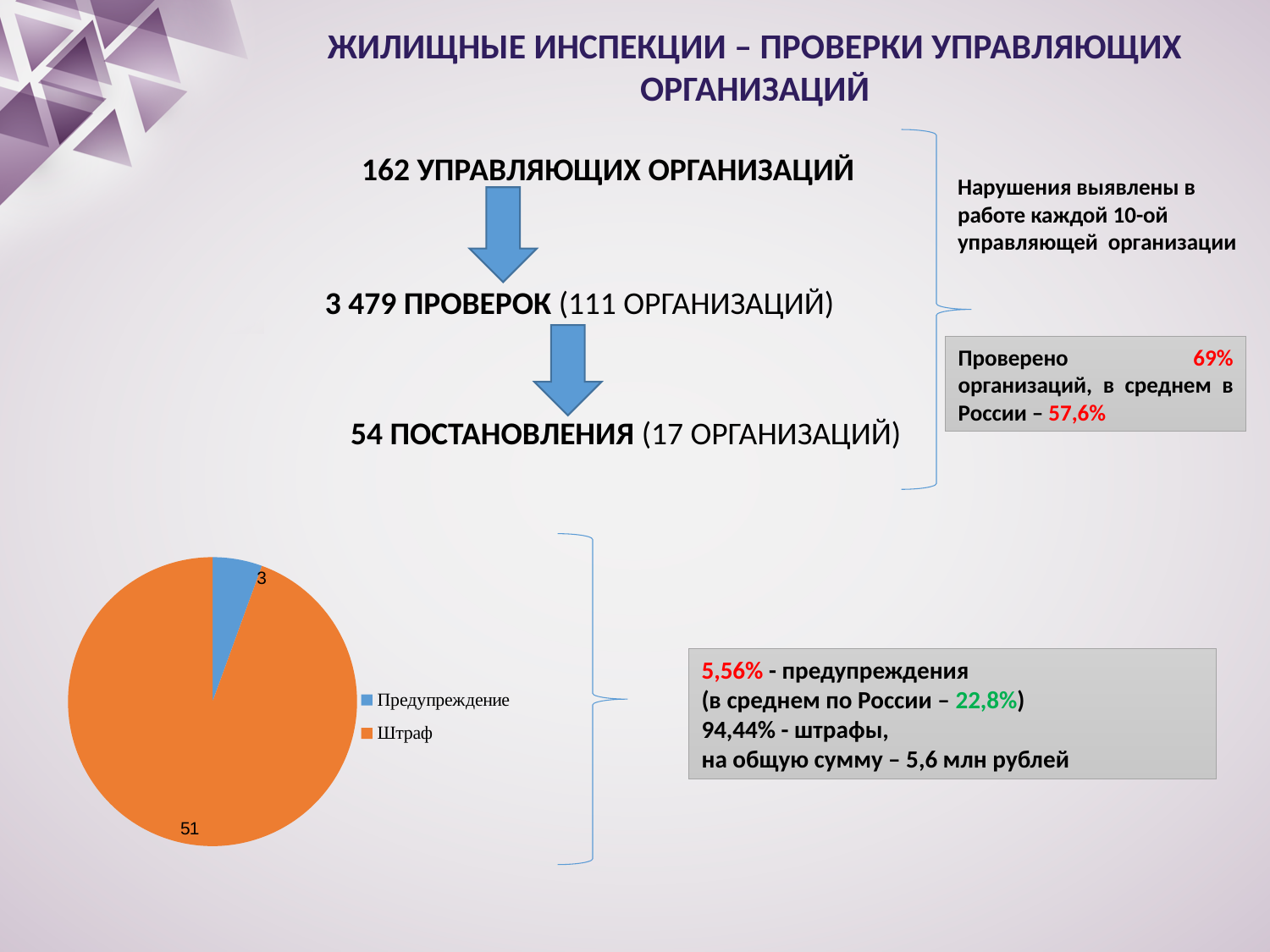
What share of the pie chart does Предупреждение represent? 5,56% How many slices does the pie chart have? 2 What colour is the Штраф slice in the pie chart? orange What is the difference between the values for Штраф and Предупреждение in the pie chart? 48 What is the value for Предупреждение in the pie chart? 3 Which category has the smallest slice in the pie chart? Предупреждение Which category has the largest slice in the pie chart? Штраф What is the value for Штраф in the pie chart? 51 What kind of chart is shown on the slide? pie chart Which is larger in the pie chart, Предупреждение or Штраф? Штраф What is the total of all slices in the pie chart? 54 What share of the pie chart does Штраф represent? 94,44%